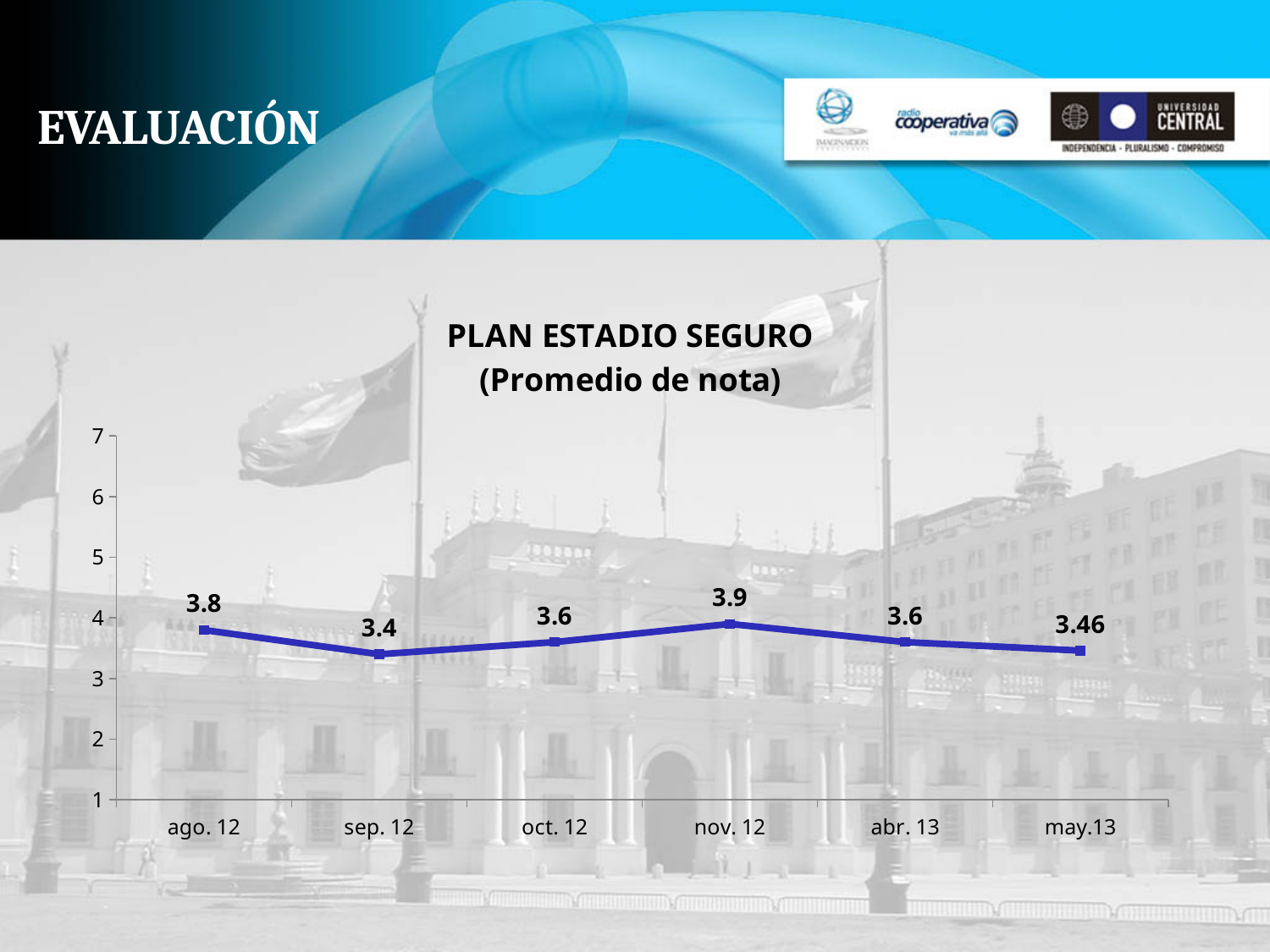
Which month has the highest value? nov. 12 What is the title of the chart? PLAN ESTADIO SEGURO (Promedio de nota) Which month has the lowest value? sep. 12 Which is larger, the value for ago. 12 or the value for may.13? ago. 12 What kind of chart is shown on the slide? line chart How many data points are plotted on the chart? 6 What is the value for ago. 12? 3.8 What is the difference between the values for nov. 12 and sep. 12? 0.5 Does the value rise or fall from nov. 12 to abr. 13? fall What is the value for may.13? 3.46 What is the value for nov. 12? 3.9 Is the value for nov. 12 greater or less than 4? less